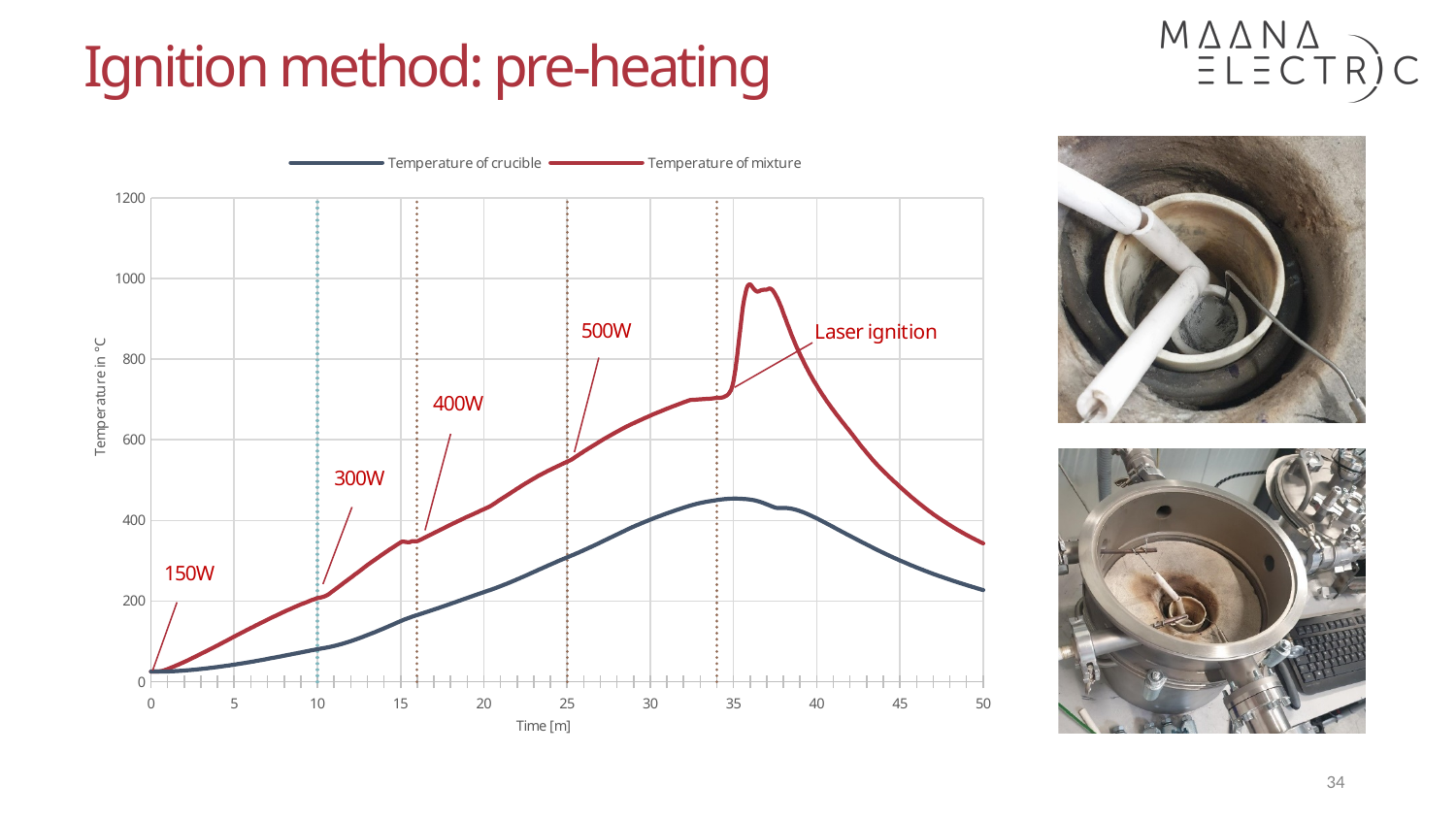
Is the value of Temperature of crucible at 35 minutes greater or less than 600? less What kind of chart is shown on the slide? line chart Does Temperature of mixture rise or fall between 40 and 50 minutes? fall At 30 minutes, which series has the higher temperature, Temperature of crucible or Temperature of mixture? Temperature of mixture Is the value of Temperature of mixture at 50 minutes greater or less than 400? less For Temperature of mixture, is the value at 20 minutes or at 40 minutes larger? 40 minutes Is the peak value of Temperature of mixture greater or less than 800? greater How many series does the chart legend list? 2 Does Temperature of crucible rise or fall between 0 and 30 minutes? rise What are the two series named in the chart legend? Temperature of crucible, Temperature of mixture Which power level is annotated at the dotted line at 25 minutes? 500W